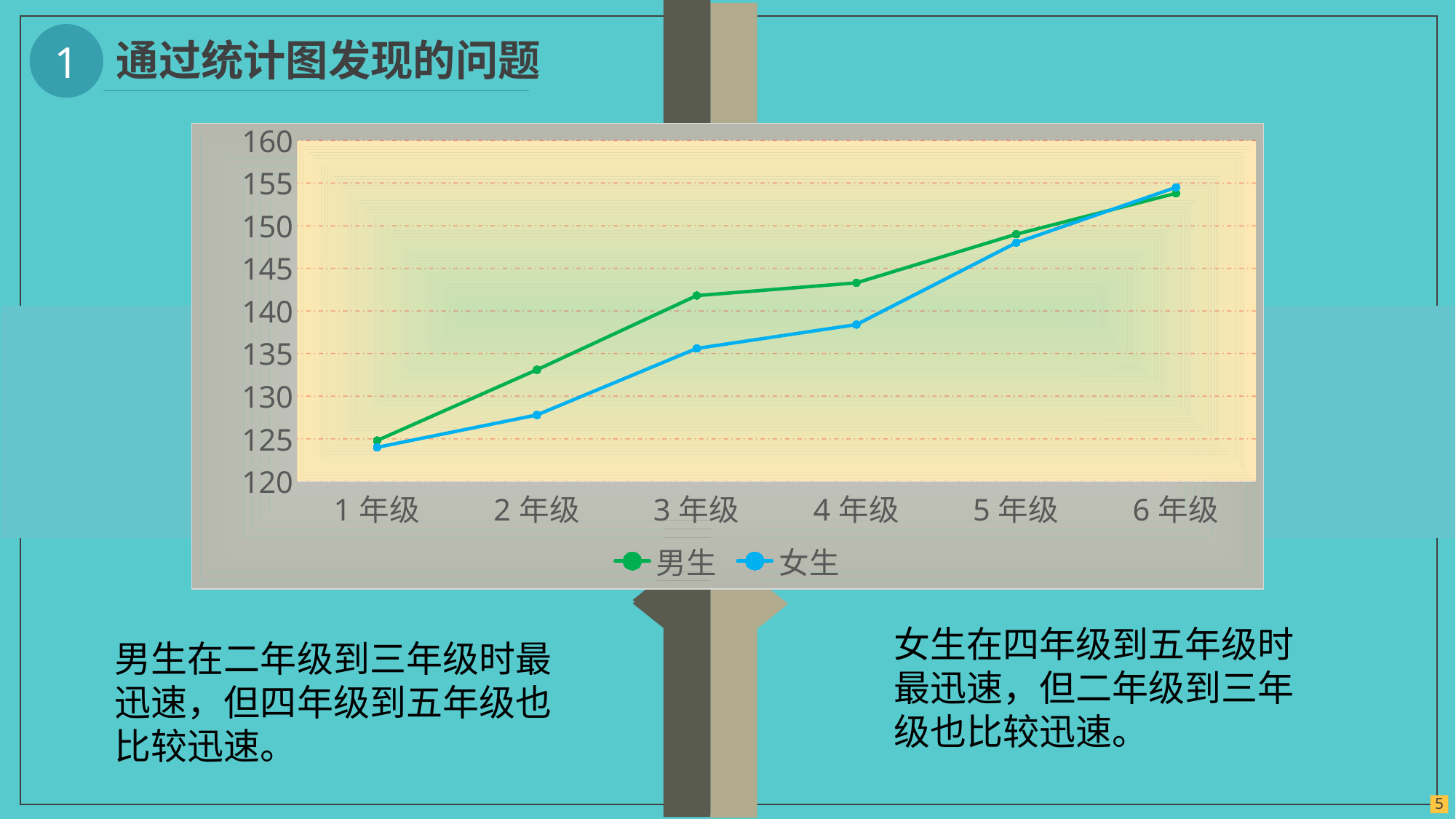
How many grade categories are shown on the x axis? 6 Is the value for 女生 at 3 年级 greater or less than 140? less Is the value for 女生 at 2 年级 greater or less than 130? less How many series does the legend list? 2 Is the value for 男生 at 6 年级 greater or less than 150? greater Do the values for 男生 rise or fall from 1 年级 to 6 年级? rise At 4 年级, which series has the higher value, 男生 or 女生? 男生 What colour is the line for 男生? green At 3 年级, which series has the higher value, 男生 or 女生? 男生 What kind of chart is shown on the slide? line chart